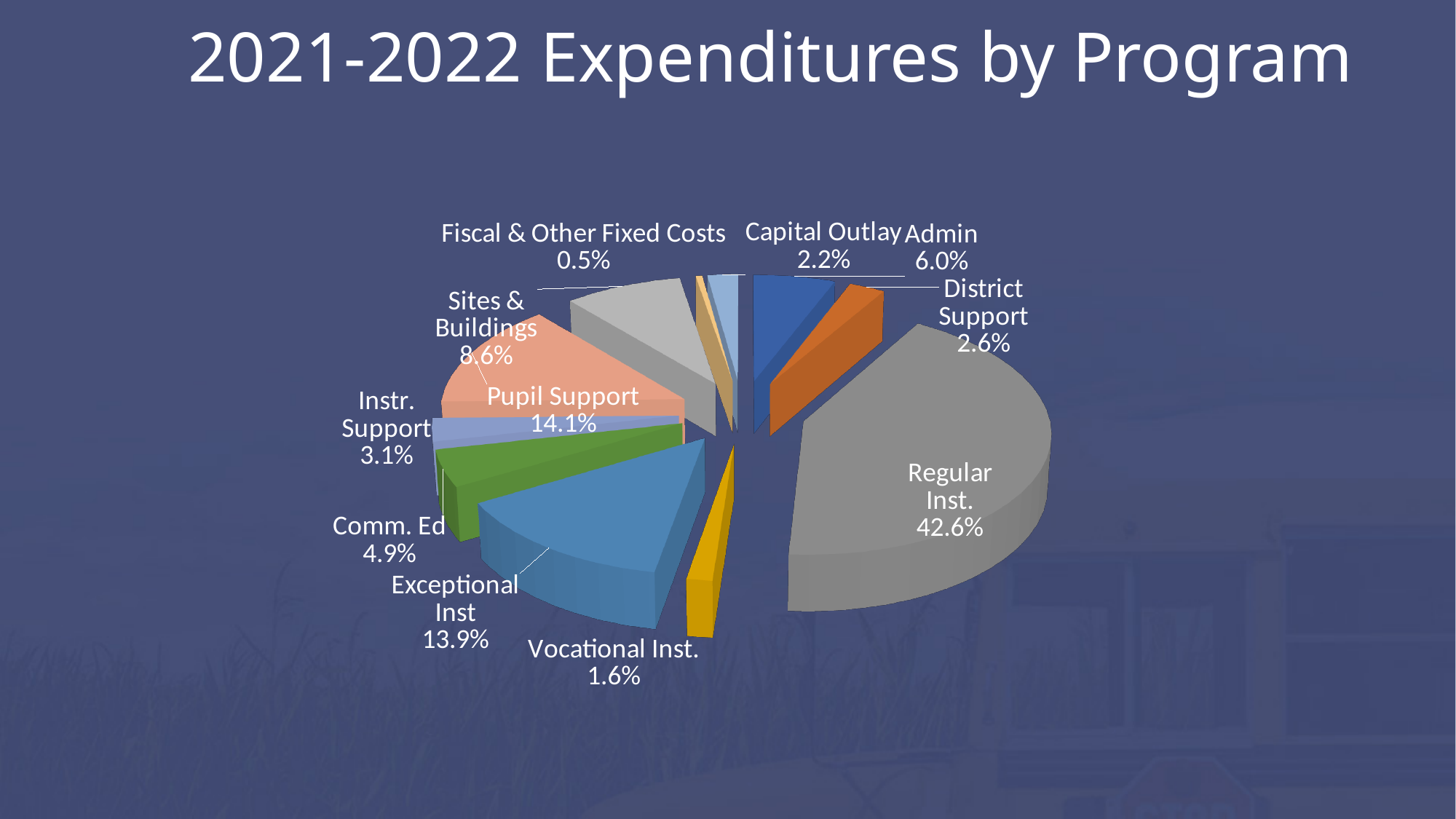
What is the title of the chart on the slide? 2021-2022 Expenditures by Program What percentage of expenditures is Capital Outlay? 2.2% What is the difference between the Admin share and the District Support share? 3.4% What percentage is shown for Pupil Support? 14.1% What type of chart is shown on the slide? Pie chart How many program categories are shown in the pie chart? 11 What share of expenditures goes to Regular Inst.? 42.6% Which program has the smallest share of expenditures? Fiscal & Other Fixed Costs What is the value labelled for Sites & Buildings? 8.6% Which program has the largest share of expenditures? Regular Inst. Which is larger, Comm. Ed or Instr. Support? Comm. Ed What is the difference in percentage points between Pupil Support and Exceptional Inst? 0.2%